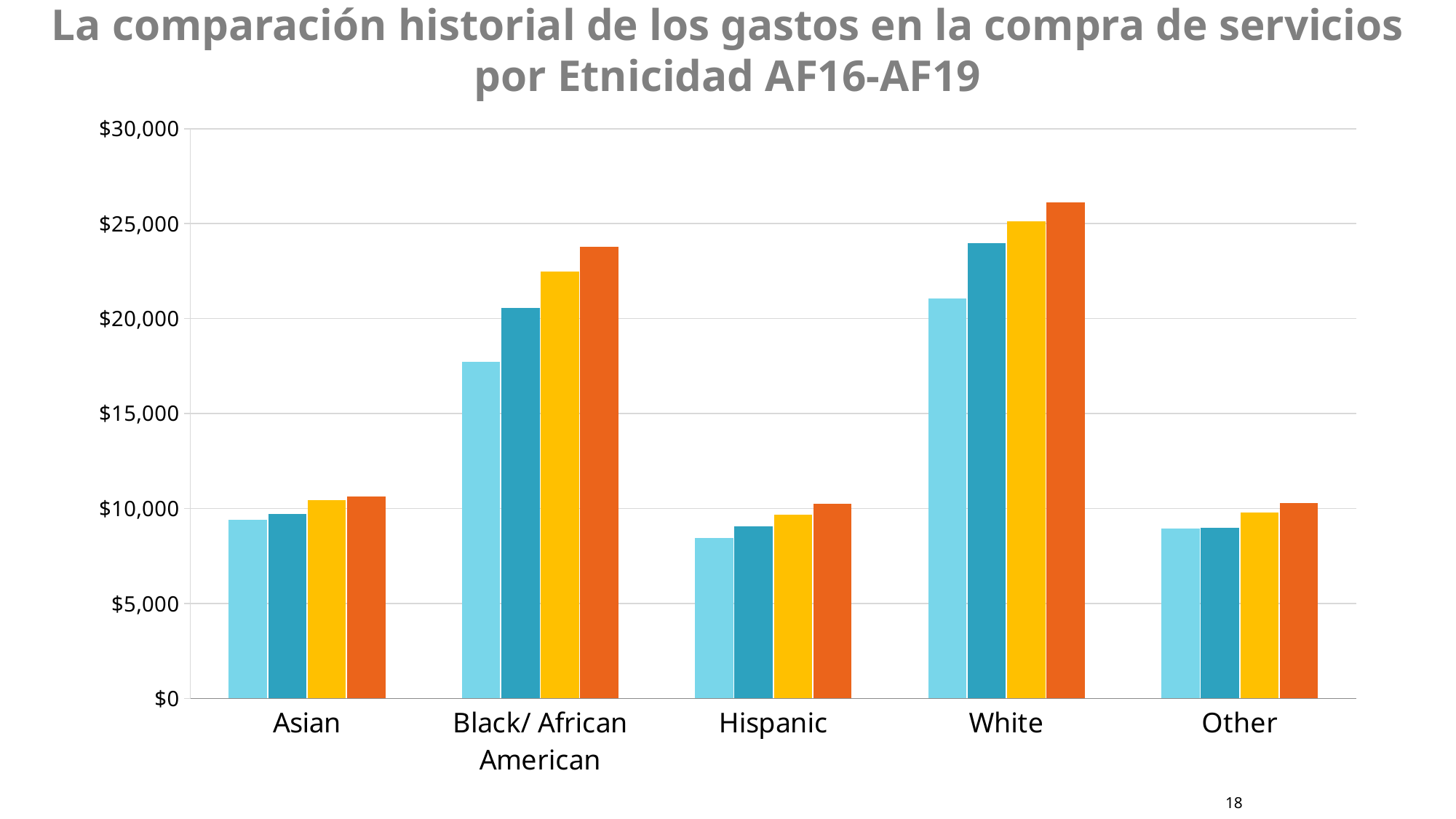
Within the White category, do the bars rise or fall from left to right? rise Which category has higher values, Black/ African American or Asian? Black/ African American What is the title of the chart? La comparación historial de los gastos en la compra de servicios por Etnicidad AF16-AF19 Is the value of the rightmost (orange) bar for Black/ African American greater or less than $20,000? greater Which category has higher values, White or Black/ African American? White Is the value of the leftmost (light blue) bar for Black/ African American greater or less than $20,000? less Which ethnicity category has the tallest bars? White What kind of chart is shown on the slide? bar chart How many ethnicity categories are shown on the x axis? 5 Is the value of the rightmost (orange) bar for White greater or less than $25,000? greater How many bars are plotted for each ethnicity category? 4